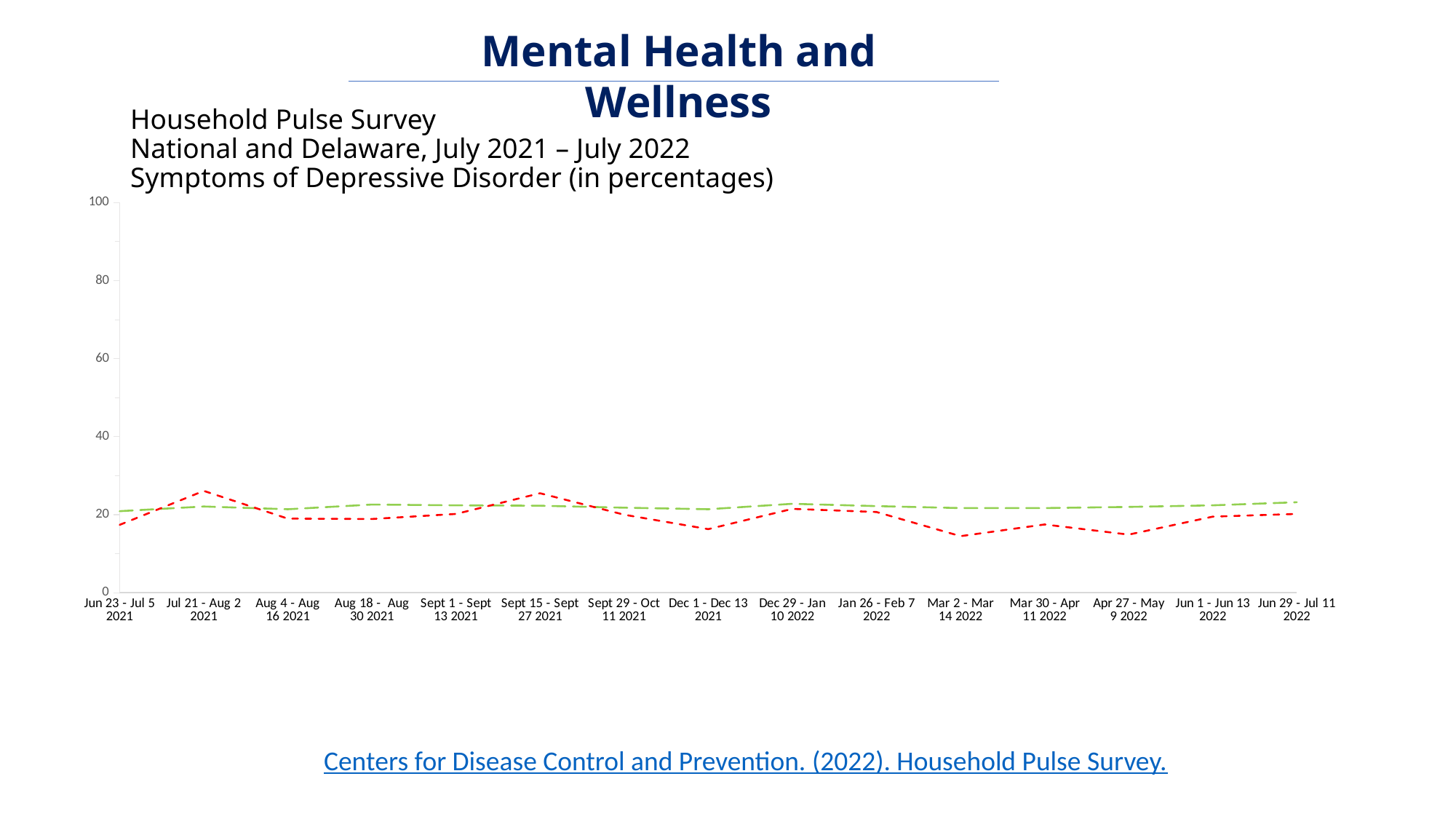
Is the value of the red dashed line for Mar 2 - Mar 14 2022 greater or less than 20? less What is the highest value shown on the chart's y axis? 100 How many survey periods are labelled along the x axis of the chart? 15 How many dashed lines are plotted on the chart? 2 Is the value of the red dashed line for Jul 21 - Aug 2 2021 greater or less than 20? greater What is the first survey period labelled on the x axis of the chart? Jun 23 - Jul 5 2021 Is the value of the green dashed line for Jun 23 - Jul 5 2021 greater or less than 40? less At Dec 1 - Dec 13 2021, which line has the higher value, the red dashed line or the green dashed line? Green dashed line At Mar 2 - Mar 14 2022, which line has the higher value, the red dashed line or the green dashed line? Green dashed line What kind of chart is shown on the slide? Line chart At Jul 21 - Aug 2 2021, which line has the higher value, the red dashed line or the green dashed line? Red dashed line